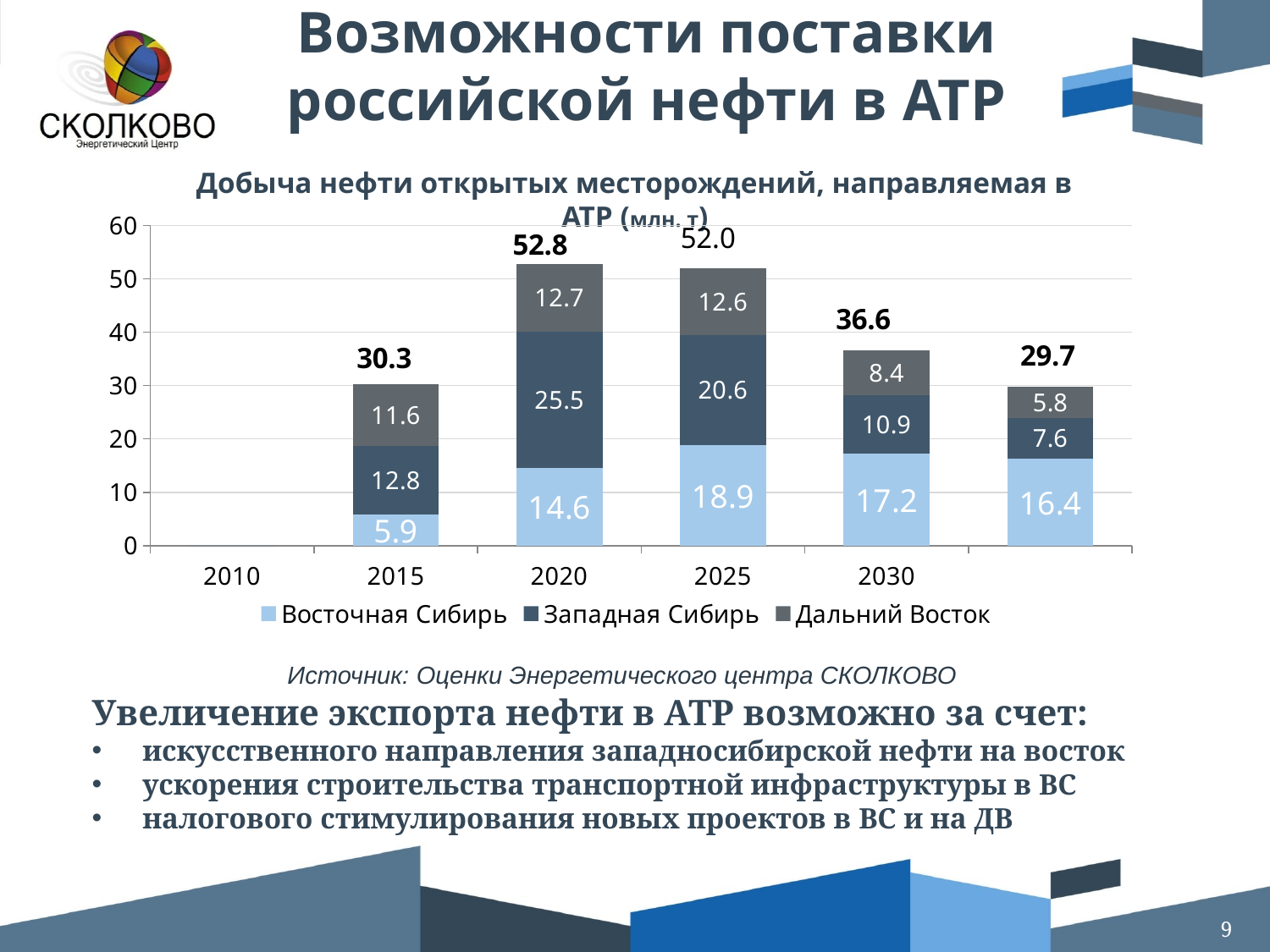
What kind of chart is shown on the slide? Stacked bar chart What is the value for Дальний Восток in 2015? 11.6 Which year has the highest total stacked bar? 2020 What is the value for Восточная Сибирь in 2020? 14.6 Which series has the largest value in 2020? Западная Сибирь Which is larger: the Восточная Сибирь value for 2025 or for 2030? 2025 What is the difference between the total for 2020 and the total for 2015? 22.5 What is the total of the stacked bar for 2025? 52.0 How many series does the legend list? 3 What is the value for Дальний Восток in 2030? 8.4 What is the difference between the Западная Сибирь values for 2020 and 2030? 14.6 Does the Западная Сибирь value rise or fall from 2020 to 2030? Fall